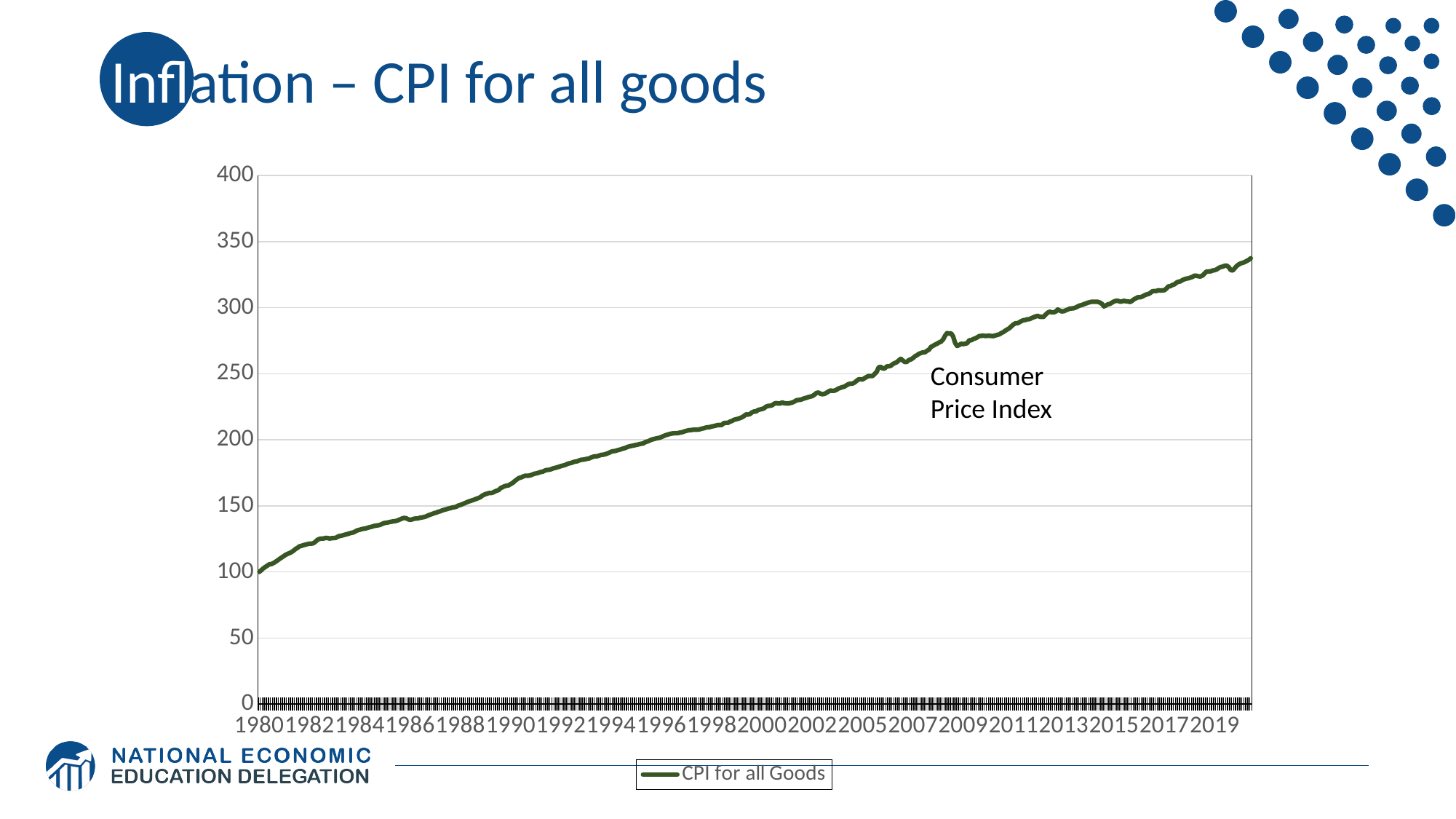
Is the value for CPI for all Goods in 1990 greater or less than 200? less What is the highest value shown on the vertical axis of the chart? 400 Which is larger, the CPI for all Goods value in 1984 or in 2013? 2013 Is the value for CPI for all Goods in 2019 greater or less than 300? greater What kind of chart is shown on the slide? Line chart Is the value for CPI for all Goods in 2011 greater or less than 250? greater Does the CPI for all Goods line generally rise or fall from 1980 to 2019? Rise How many series does the legend list? 1 What is the name of the series shown in the legend? CPI for all Goods What is the title of the slide containing the chart? Inflation – CPI for all goods